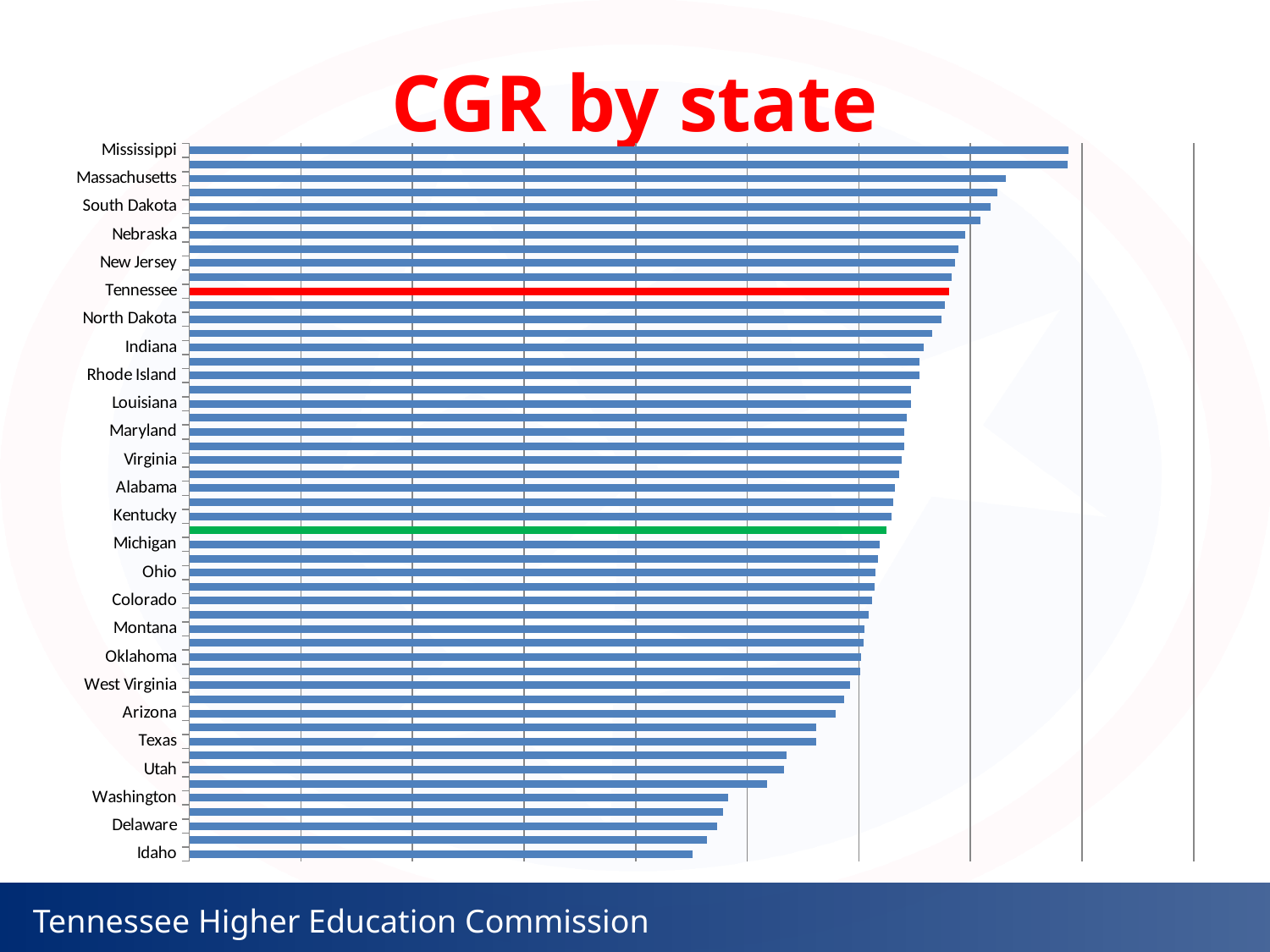
Which labeled state has the lowest value in the chart? Idaho What kind of chart is shown on the slide? Bar chart How many state labels are shown on the vertical axis of the chart? 26 Which has the larger value, Mississippi or Idaho? Mississippi Which has the larger value, Massachusetts or Texas? Massachusetts Which has the larger value, Kentucky or Washington? Kentucky Which state has the highest value in the chart? Mississippi What is the title of the chart? CGR by state Do the bar values rise or fall going from the top of the chart to the bottom? Fall What colour is the bar for Tennessee? Red